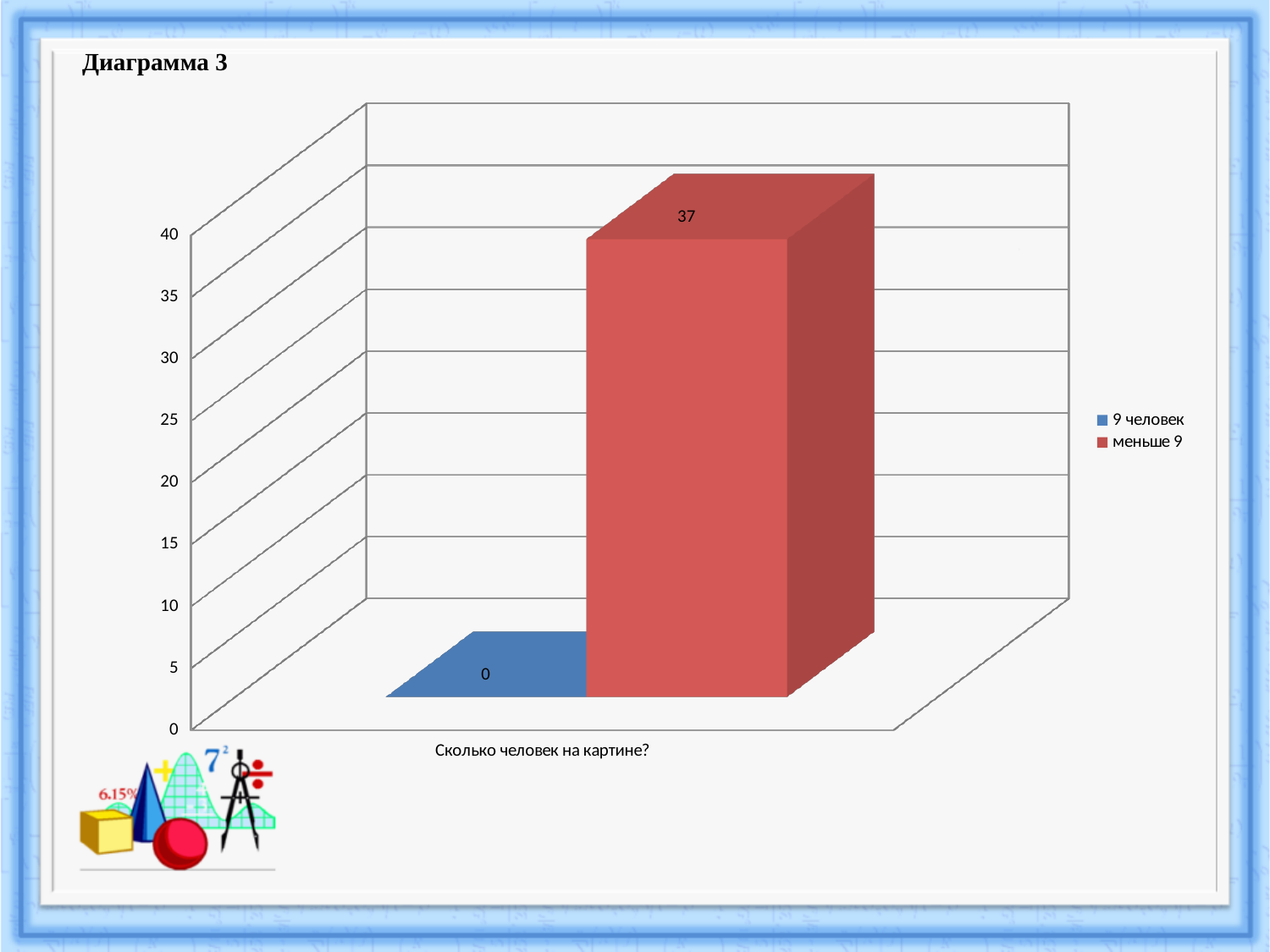
What is the value for "9 человек"? 0 What is the difference between the values for "меньше 9" and "9 человек"? 37 How many series does the legend list? 2 What colour is the bar for "меньше 9"? red Which series has the lowest value? 9 человек What is the category label on the x axis? Сколько человек на картине? Is the value for "меньше 9" greater or less than 30? greater Which series has the highest value? меньше 9 Which is larger, the value for "меньше 9" or for "9 человек"? меньше 9 What kind of chart is shown? bar chart What is the value for "меньше 9"? 37 What is the total of the two plotted values? 37